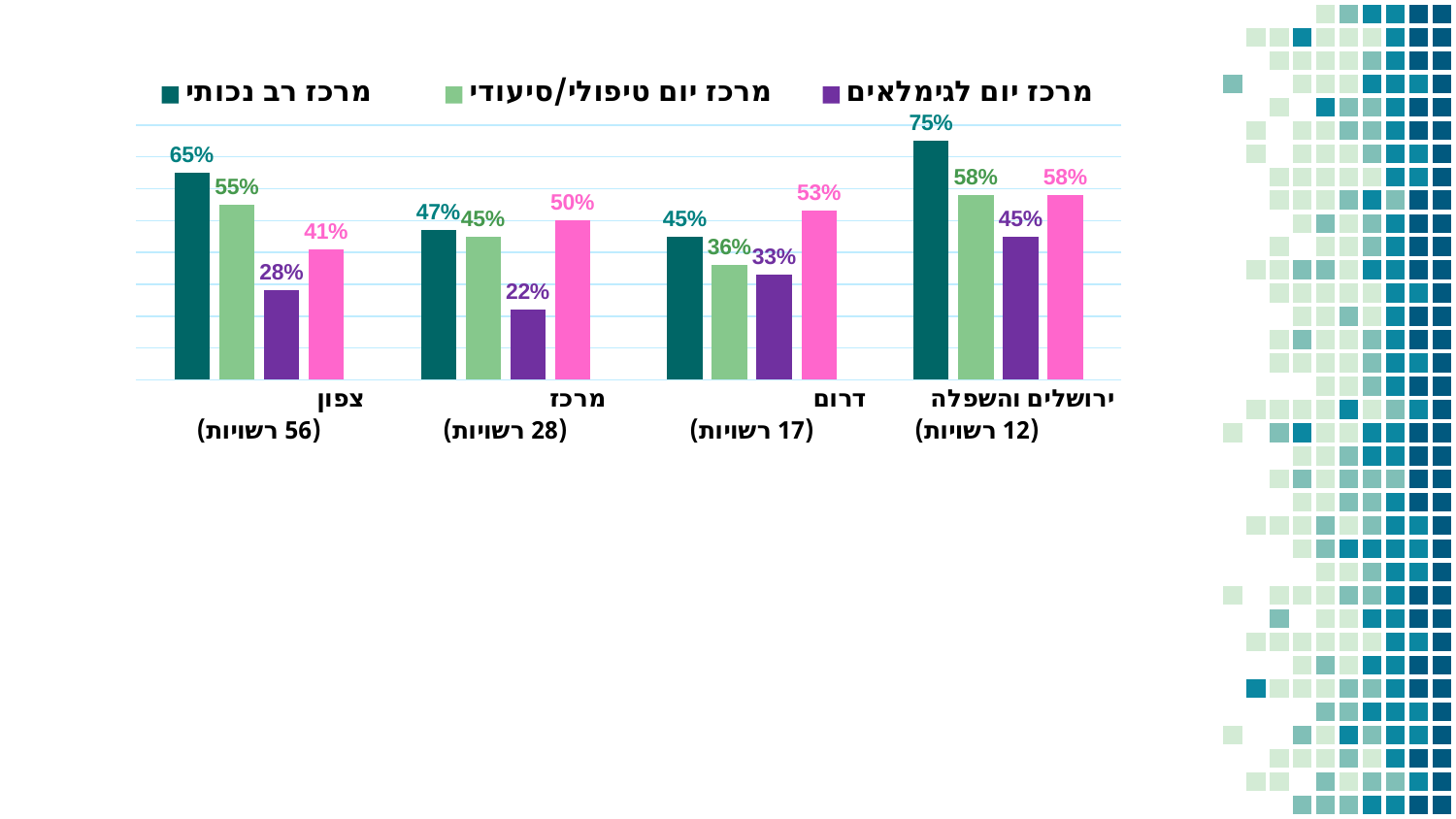
What is the value of מרכז רב נכותי for צפון? 65% Which is larger for דרום: מרכז רב נכותי or the pink bar? the pink bar How many regions are shown on the x axis? 4 What kind of chart is shown on the slide? bar chart What is the value of מרכז יום טיפולי/סיעודי for דרום? 36% What is the difference between מרכז רב נכותי and מרכז יום לגימלאים for צפון? 37% Which region has the highest value for מרכז רב נכותי? ירושלים והשפלה How many series does the legend list? 3 What is the value of מרכז יום לגימלאים for מרכז? 22% How many רשויות are indicated for the צפון region? 56 Which region has the lowest value for מרכז יום לגימלאים? מרכז What is the value of the pink bar for ירושלים והשפלה? 58%